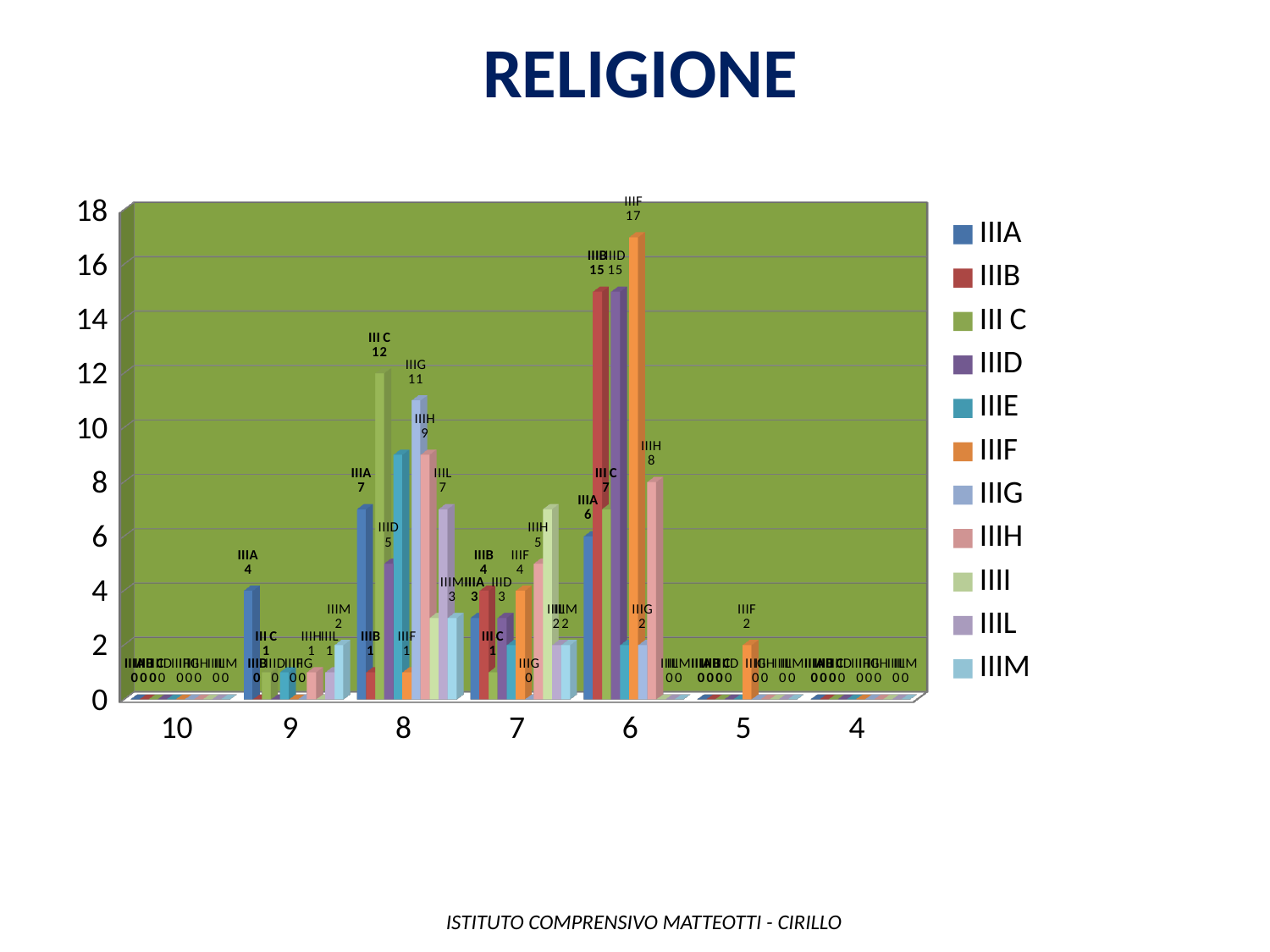
Which is larger at grade 8: the value for IIIG or the value for IIIH? IIIG What is the value for IIIF at grade 6? 17 What is the value for IIIF at grade 5? 2 What is the value for IIIG at grade 8? 11 What is the title of the chart? RELIGIONE Which series has the highest value at grade 6? IIIF What type of chart is shown on the slide? bar chart How many series does the legend list? 11 How many grade categories are shown on the x axis? 7 What is the difference between the IIIF value at grade 6 and the IIIH value at grade 6? 9 What is the value for IIIA at grade 9? 4 What is the value for III C at grade 8? 12